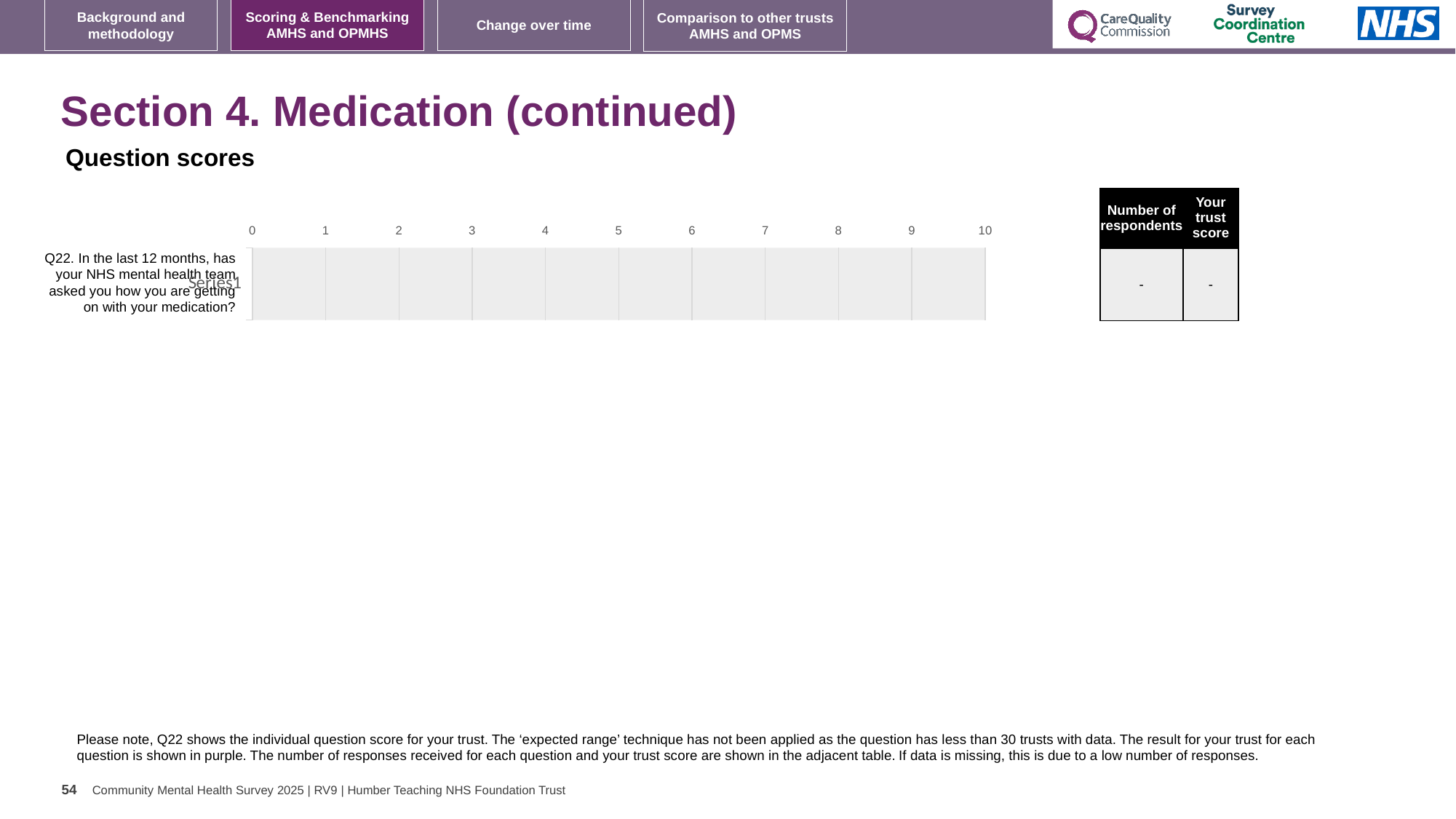
What is the highest value shown on the chart's horizontal axis? 10 What is shown in the 'Your trust score' column of the table for Q22? - What is shown in the 'Number of respondents' column of the table for Q22? - What series name is shown next to the Q22 category on the chart? Series1 How many question categories are plotted on the chart? 1